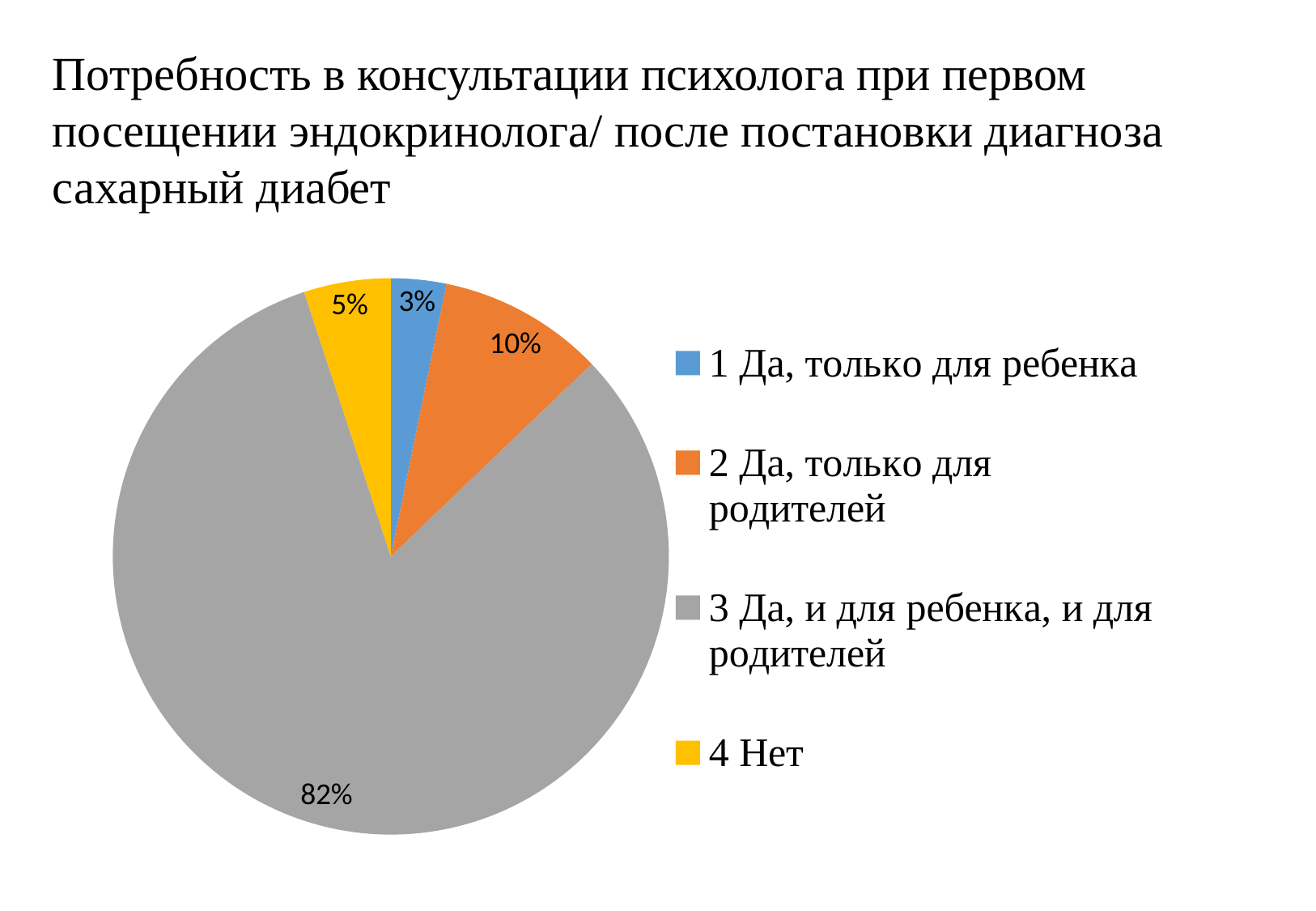
What colour is the slice for "4 Нет"? yellow What is the difference between the values for "2 Да, только для родителей" and "4 Нет"? 5% Which is larger: the slice for "4 Нет" or the slice for "1 Да, только для ребенка"? 4 Нет How many categories does the pie chart have? 4 What is the difference between the values for "3 Да, и для ребенка, и для родителей" and "2 Да, только для родителей"? 72% Which category has the smallest slice of the pie? 1 Да, только для ребенка What is the value shown for "1 Да, только для ребенка"? 3% What type of chart is shown on the slide? pie chart What is the value shown for "4 Нет"? 5% Which category has the largest slice of the pie? 3 Да, и для ребенка, и для родителей What is the value shown for "2 Да, только для родителей"? 10% What share of the pie does "3 Да, и для ребенка, и для родителей" take? 82%